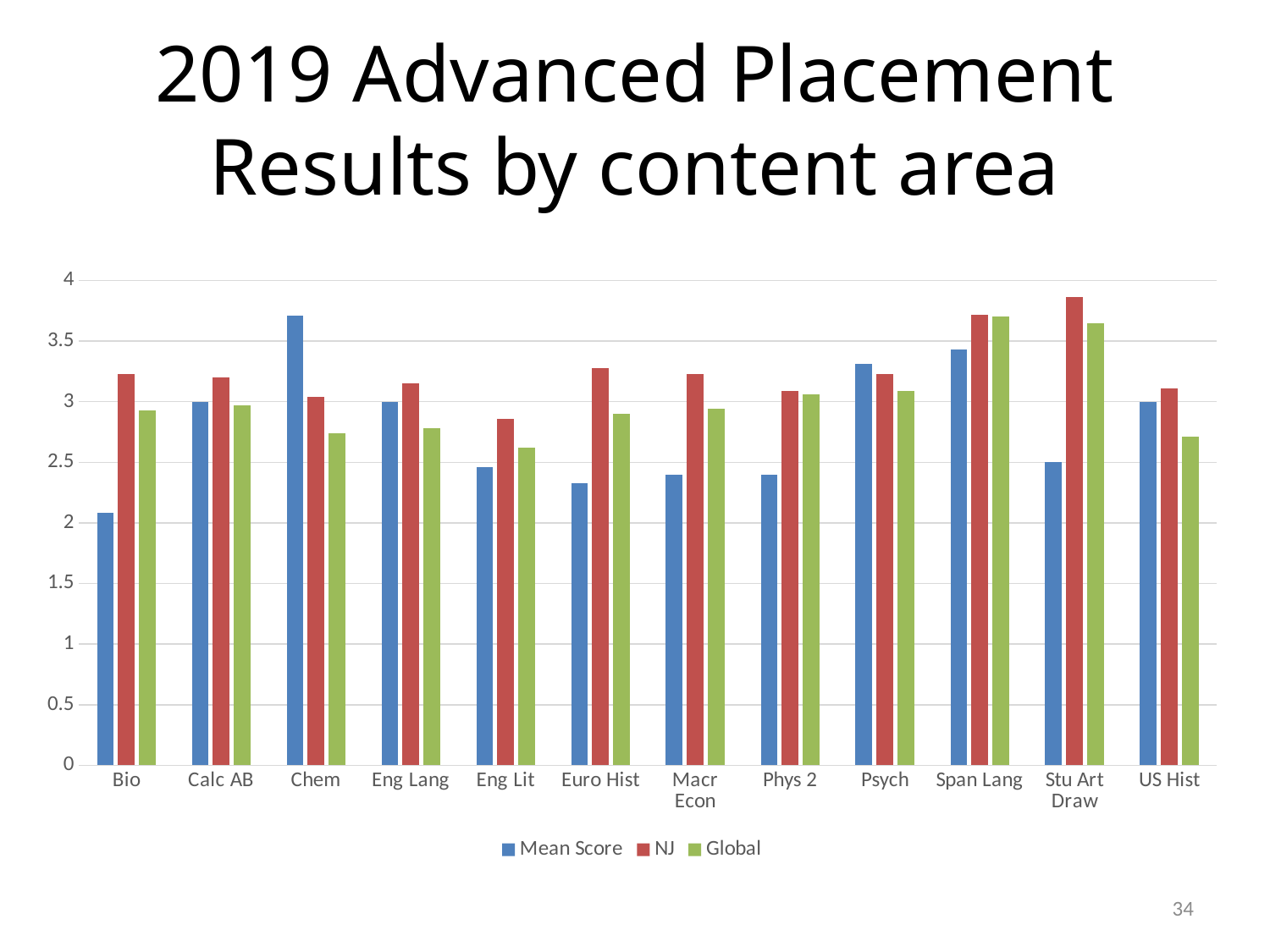
Is the Mean Score for Bio greater or less than 2.5? less Which content area has the highest NJ value? Stu Art Draw For Bio, which is larger: the Mean Score or the NJ value? NJ Which content area has the lowest Mean Score? Bio Which series is shown in green in the legend? Global Which content area has the highest Mean Score? Chem What kind of chart is shown on the slide? bar chart Which content area has the lowest NJ value? Eng Lit How many series does the legend list? 3 How many content areas (categories) are shown on the x axis? 12 Is the NJ value for Eng Lit greater or less than 3? less Is the Mean Score for Chem greater or less than 3.5? greater